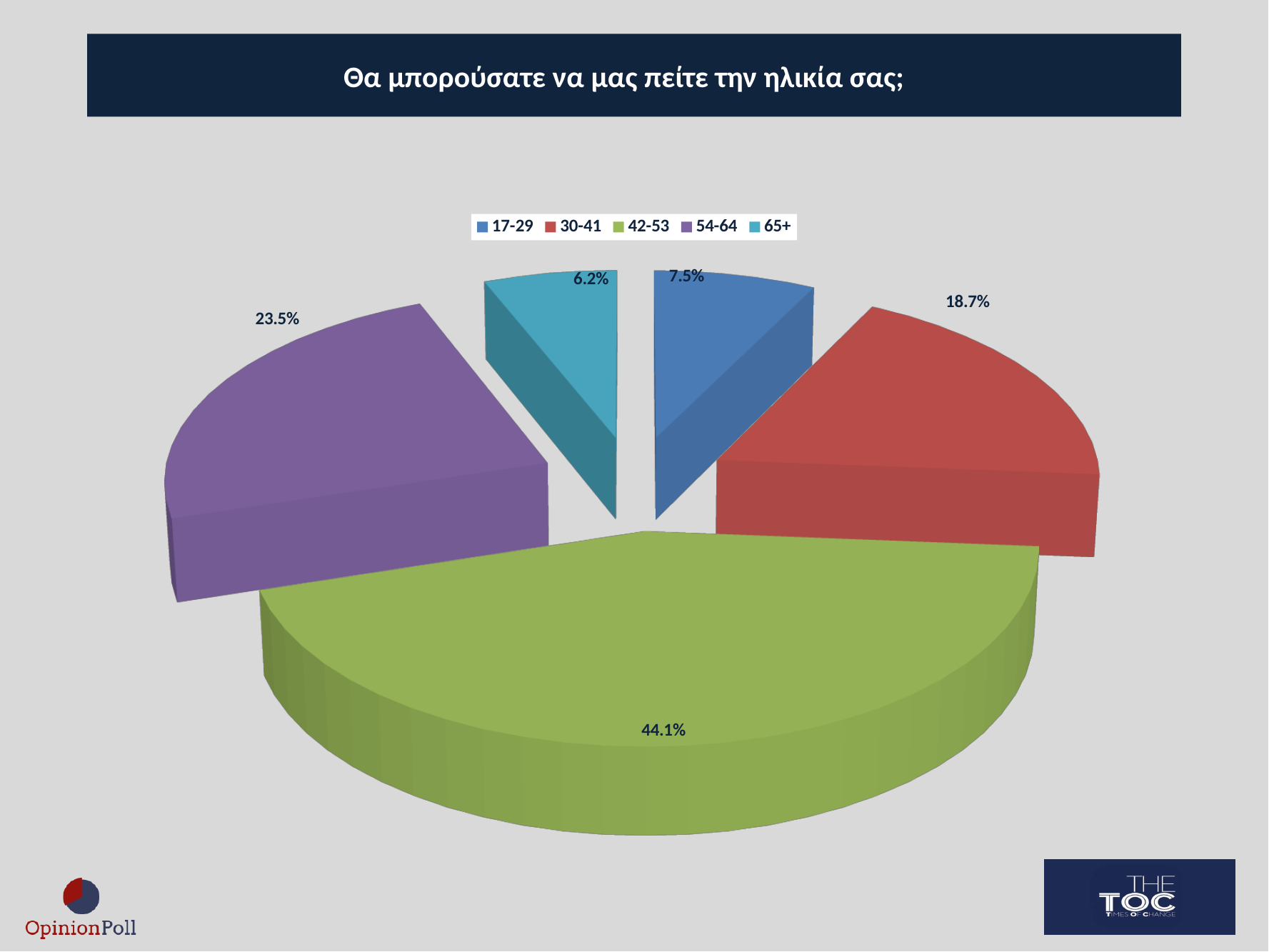
What percentage of respondents are in the 42-53 age group? 44.1% What is the value shown for the 30-41 age group? 18.7% What percentage of respondents are aged 65+? 6.2% What type of chart is shown on the slide? Pie chart How many age groups are shown in the pie chart? 5 What is the combined share of the 17-29 and 30-41 age groups? 26.2% What is the difference between the 54-64 and 30-41 shares? 4.8% Which is larger, the share for 17-29 or the share for 65+? 17-29 What is the value shown for the 54-64 age group? 23.5% What colour is the slice for the 54-64 age group? Purple Which age group has the smallest share of the pie? 65+ Which age group has the largest share of the pie? 42-53